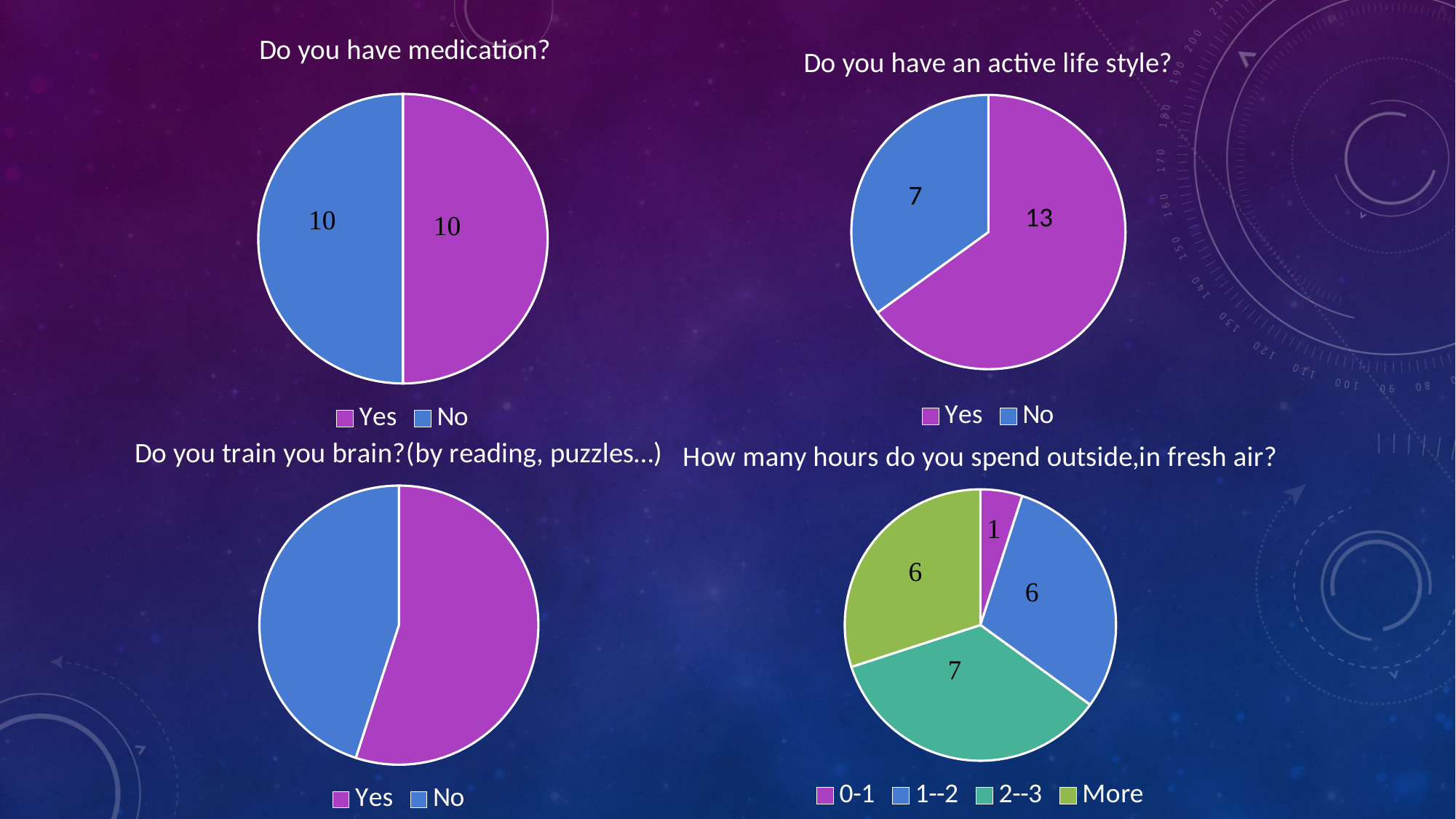
In the 'How many hours do you spend outside,in fresh air?' chart, what is the total of all slices? 20 In the 'How many hours do you spend outside,in fresh air?' chart, how many categories are shown? 4 In the 'Do you have an active life style?' chart, what is the difference between Yes and No? 6 In the 'Do you have an active life style?' chart, what is the value for No? 7 In the 'Do you have medication?' chart, what is the value for Yes? 10 In the 'How many hours do you spend outside,in fresh air?' chart, which category is the smallest? 0-1 In the 'Do you train you brain?' chart, which slice is larger, Yes or No? Yes In the 'How many hours do you spend outside,in fresh air?' chart, what is the value for 2--3? 7 In the 'Do you have an active life style?' chart, which category is the largest? Yes What kind of chart is used for 'Do you have medication?' Pie chart How many charts are on the slide? 4 In the 'Do you have an active life style?' chart, what share of the pie does Yes represent? 65%